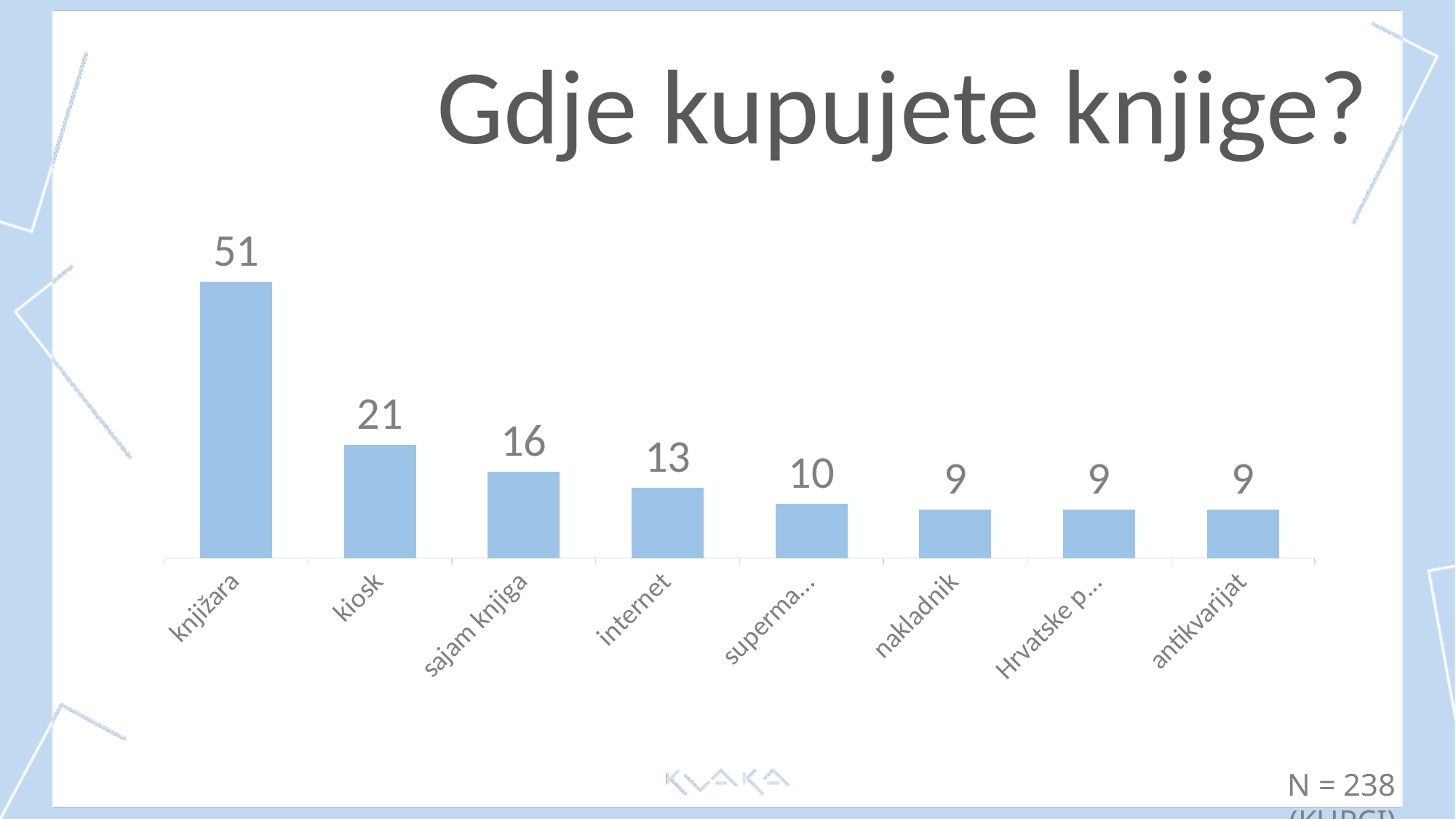
Do the values rise or fall from left to right along the x axis? fall What is the difference between the values for knjižara and kiosk? 30 Which is larger, the value for kiosk or the value for internet? kiosk What value is shown for knjižara? 51 What is the lowest value shown on the chart? 9 What value is shown for kiosk? 21 How many categories are shown on the chart? 8 What value is shown for sajam knjiga? 16 What kind of chart is shown on the slide? bar chart What value is shown for antikvarijat? 9 What value is shown for internet? 13 Which category has the highest value? knjižara